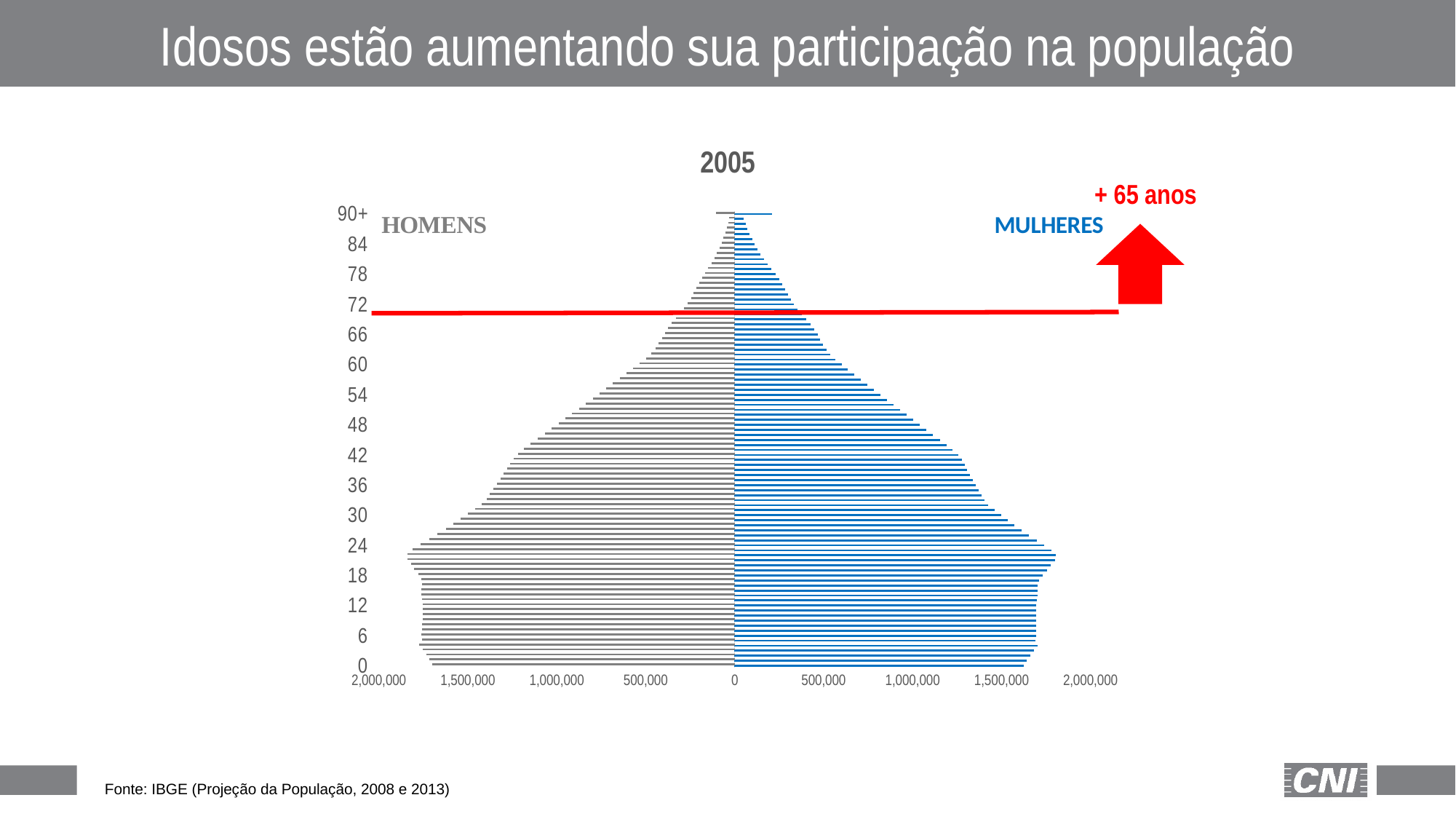
What kind of chart is shown on the slide? bar chart Which series is plotted on the left side of the chart? HOMENS What is the title of the chart? 2005 Is the value for MULHERES at age 54 greater or less than 500,000? greater Is the value for HOMENS at age 42 greater or less than 1,000,000? greater How many series (population groups) does the chart show? 2 Is the value for MULHERES at age 0 greater or less than 1,500,000? greater Do the bar lengths rise or fall as age increases from 24 to 90+? fall How many age labels are shown on the vertical axis? 16